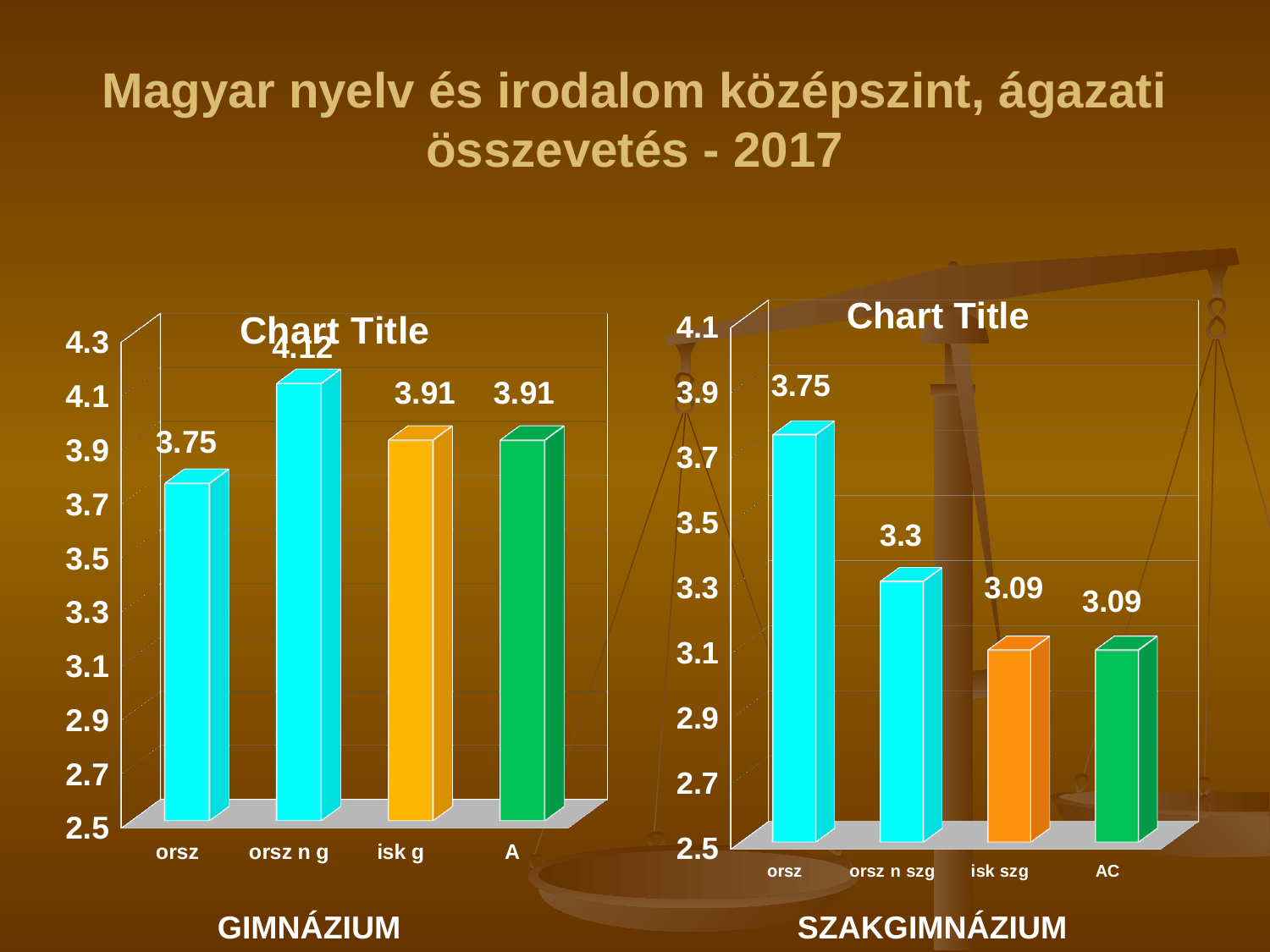
In the right chart (SZAKGIMNÁZIUM), what is the value for AC? 3.09 In the left chart (GIMNÁZIUM), which category has the highest value? orsz n g In the right chart (SZAKGIMNÁZIUM), what is the difference between the values for orsz and isk szg? 0.66 In the right chart (SZAKGIMNÁZIUM), which is larger, the value for orsz n szg or the value for isk szg? orsz n szg In the right chart (SZAKGIMNÁZIUM), which category has the highest value? orsz In the right chart (SZAKGIMNÁZIUM), what is the value for orsz n szg? 3.3 In the left chart (GIMNÁZIUM), what is the value for orsz n g? 4.12 How many bars are shown in the right chart (SZAKGIMNÁZIUM)? 4 In the left chart (GIMNÁZIUM), what is the value for isk g? 3.91 In the left chart (GIMNÁZIUM), what is the difference between the values for orsz n g and orsz? 0.37 In the left chart (GIMNÁZIUM), which category has the lowest value? orsz What type of chart is the left chart (GIMNÁZIUM)? bar chart